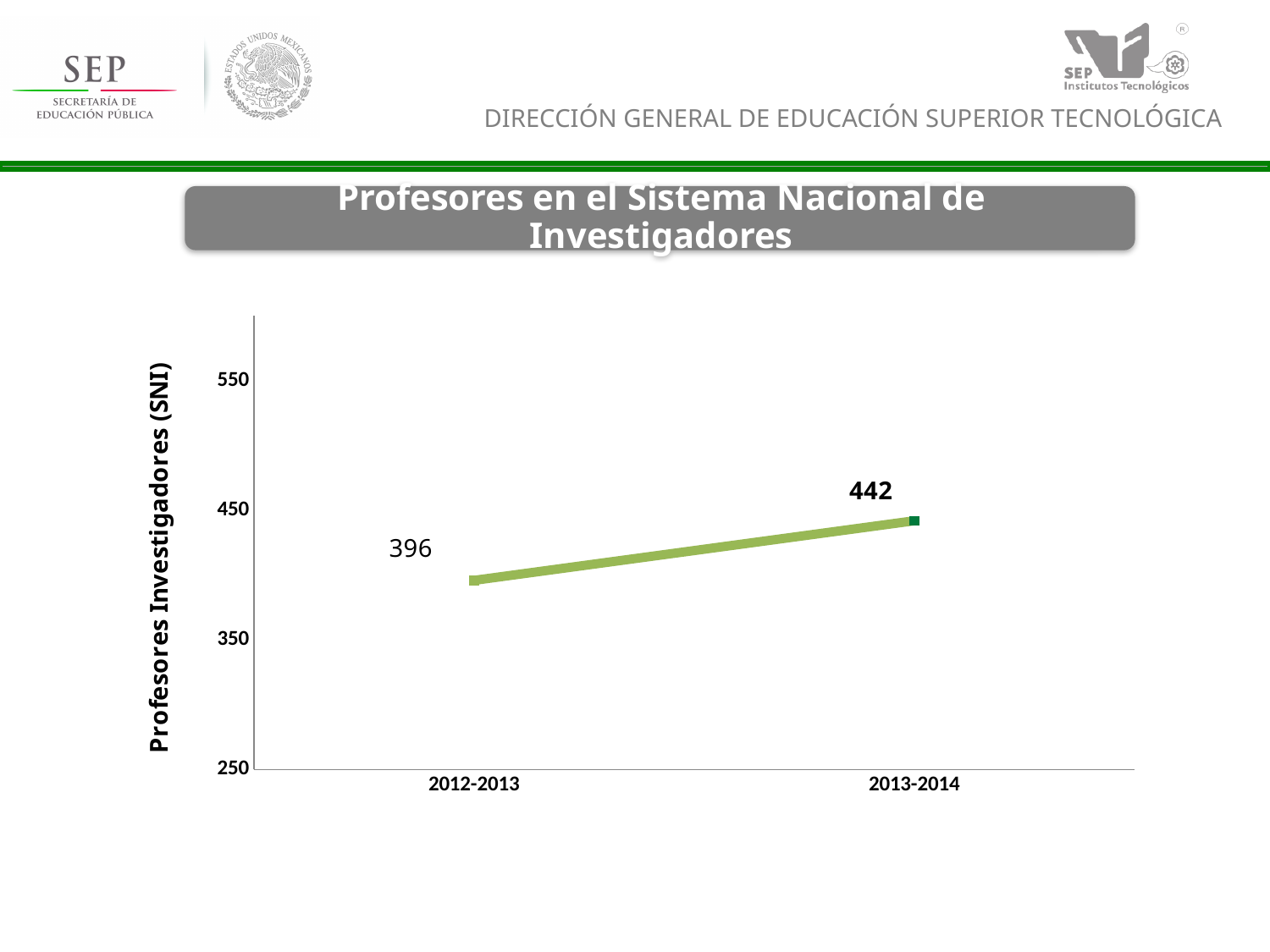
Which period has the lowest value? 2012-2013 Do the values rise or fall from 2012-2013 to 2013-2014? rise Which is larger, the value for 2012-2013 or the value for 2013-2014? 2013-2014 What is the value for 2013-2014? 442 What is the difference between the values for 2013-2014 and 2012-2013? 46 What kind of chart is shown on the slide? line chart How many periods are plotted on the x axis? 2 What is the label of the y axis? Profesores Investigadores (SNI) Which period has the highest value? 2013-2014 Is the value for 2013-2014 greater or less than 450? less Is the value for 2012-2013 greater or less than 350? greater What is the value for 2012-2013? 396